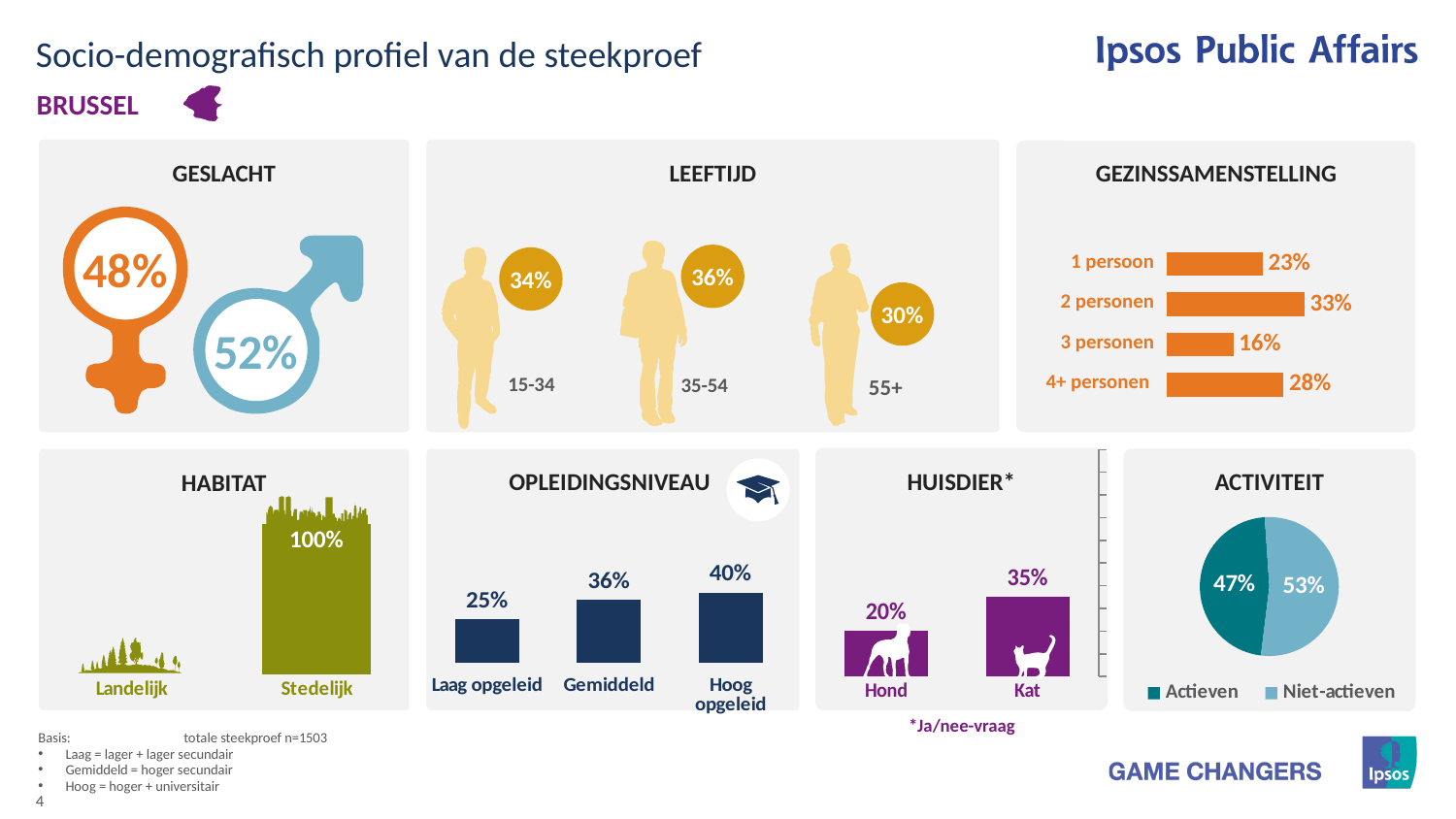
In the HUISDIER chart, what is the difference between Kat and Hond? 15% In the ACTIVITEIT chart, what share of the pie is Actieven? 47% In the GEZINSSAMENSTELLING chart, what is the value for 2 personen? 33% How many categories does the GEZINSSAMENSTELLING chart show? 4 How many series does the legend of the ACTIVITEIT chart list? 2 In the OPLEIDINGSNIVEAU chart, what is the value for Gemiddeld? 36% In the GEZINSSAMENSTELLING chart, which category has the lowest value? 3 personen In the GEZINSSAMENSTELLING chart, what is the difference between 4+ personen and 1 persoon? 5% In the OPLEIDINGSNIVEAU chart, which category has the highest value? Hoog opgeleid In the OPLEIDINGSNIVEAU chart, do the values rise or fall from Laag opgeleid to Hoog opgeleid? rise In the HUISDIER chart, which is larger, Hond or Kat? Kat What kind of chart is the ACTIVITEIT chart? pie chart